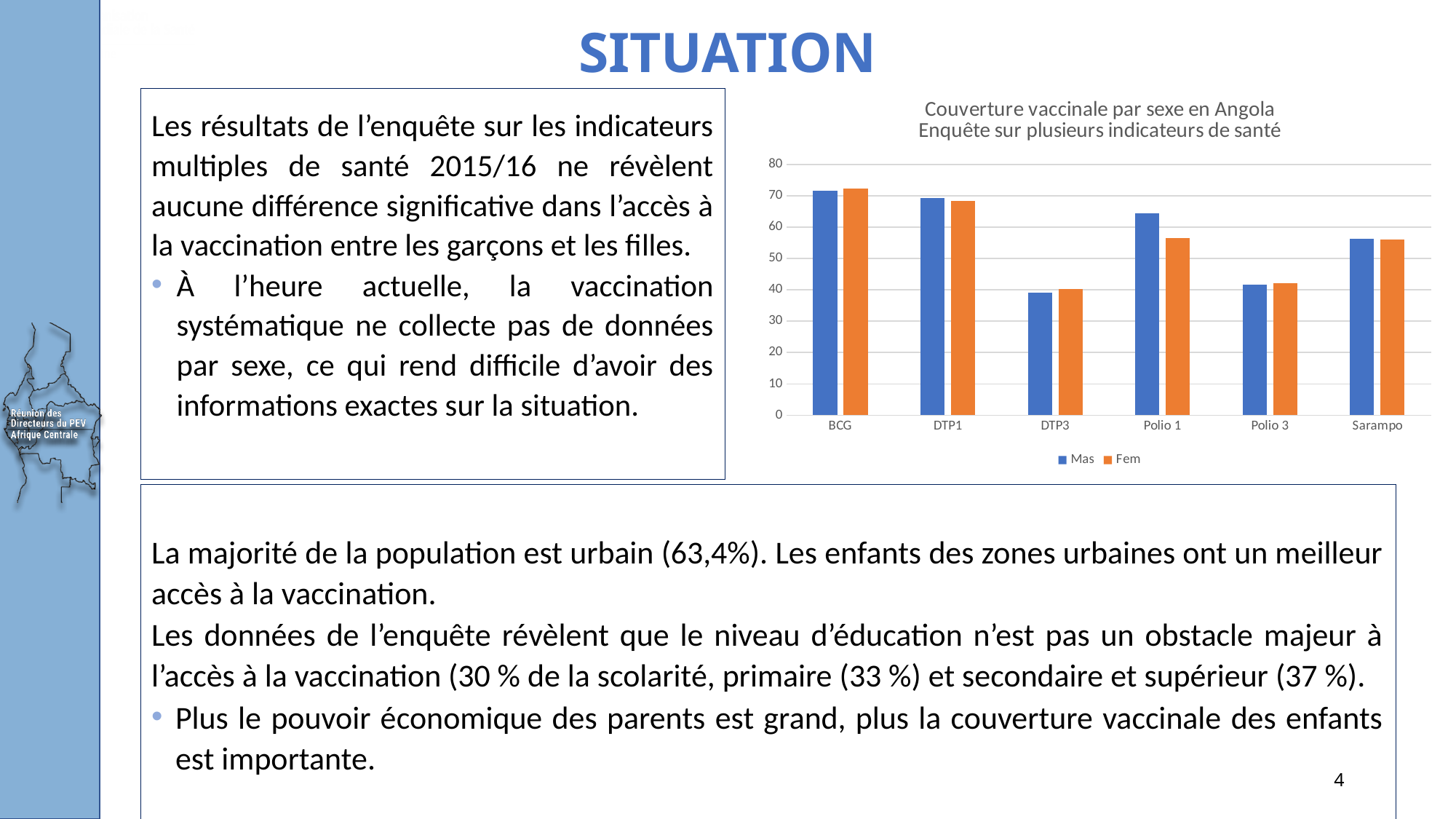
How many series does the chart legend list? 2 Is the Fem value for Polio 3 greater or less than 50? less How many vaccine categories are shown on the x axis of the chart? 6 For Polio 1, which series has the larger value, Mas or Fem? Mas What kind of chart is shown on the slide? bar chart Which vaccine category has the lowest coverage for the Fem series? DTP3 Is the Mas value for Polio 1 greater or less than 60? greater Is the Fem value for DTP3 greater or less than 50? less Which vaccine category has the lowest coverage for the Mas series? DTP3 What are the two series named in the chart legend? Mas and Fem Which vaccine category has the highest coverage for the Fem series? BCG